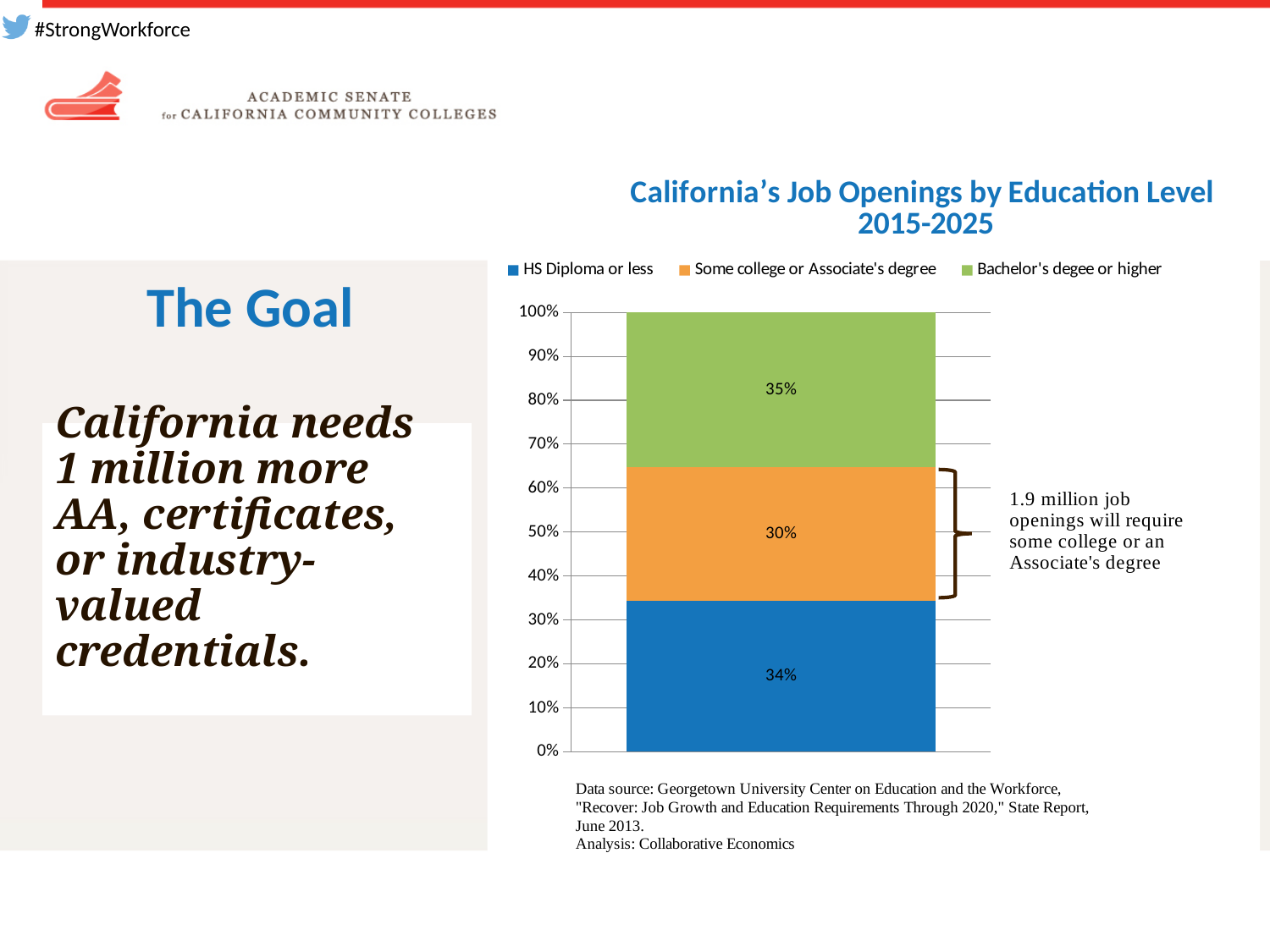
How many series does the legend list? 3 What kind of chart is shown on the slide? Stacked bar chart According to the annotation, how many job openings will require some college or an Associate's degree? 1.9 million What is the title of the chart? California's Job Openings by Education Level 2015-2025 Which education level accounts for the smallest share of California's job openings 2015-2025? Some college or Associate's degree What share of California's job openings 2015-2025 require an HS Diploma or less? 34% What is the difference between the share for Bachelor's degree or higher and the share for some college or Associate's degree? 5% What share of California's job openings 2015-2025 require a Bachelor's degree or higher? 35% Which education level accounts for the largest share of California's job openings 2015-2025? Bachelor's degee or higher Which colour represents HS Diploma or less in the chart? Blue Which is larger: the share for HS Diploma or less or the share for some college or Associate's degree? HS Diploma or less What share of California's job openings 2015-2025 require some college or an Associate's degree? 30%